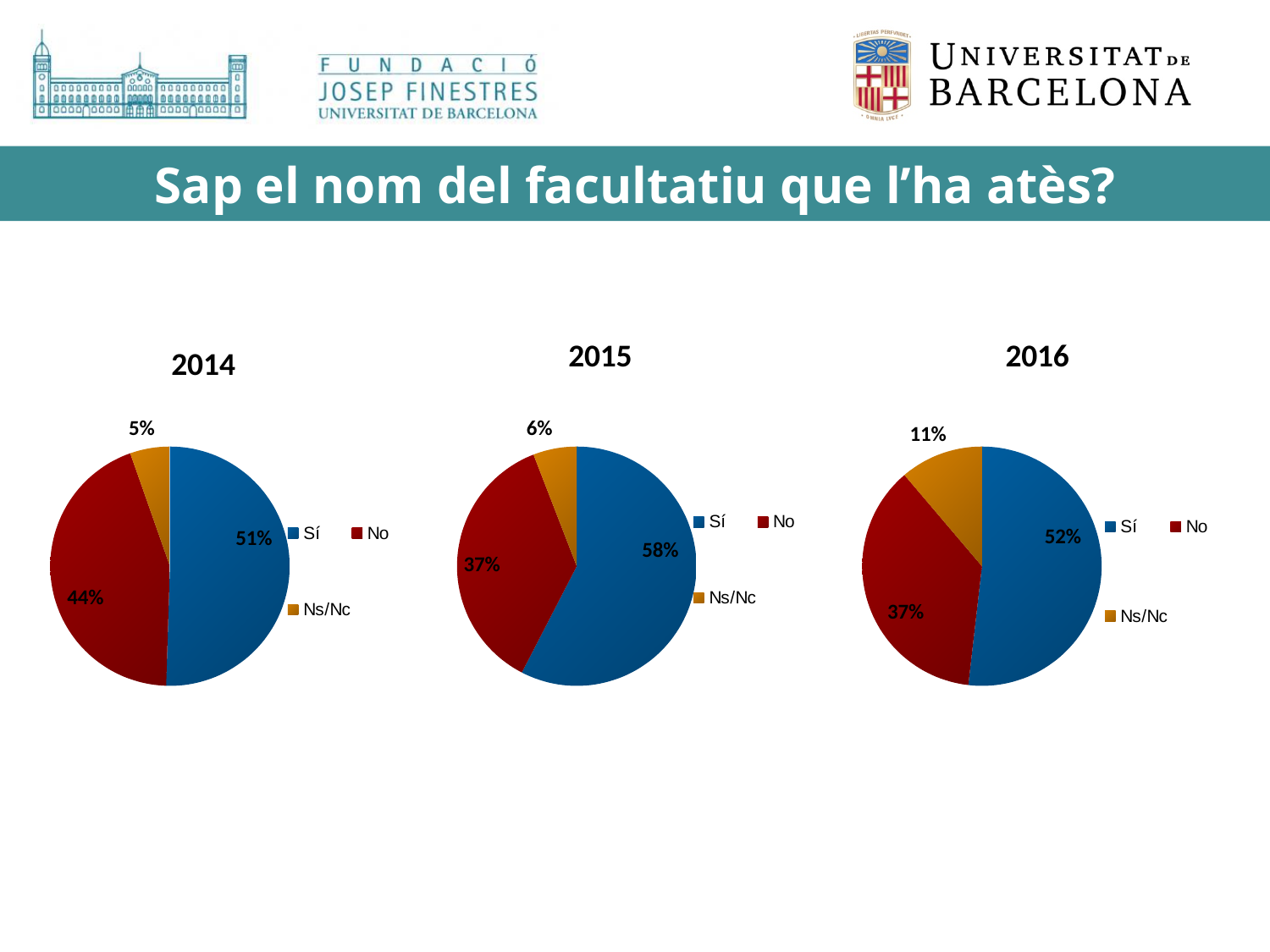
In the 2014 pie chart, what share of respondents answered Sí? 51% What kind of chart is used for the 2015 data? Pie chart In the 2016 pie chart, which category has the largest slice? Sí In the 2015 pie chart, what share of respondents answered Sí? 58% In the 2014 pie chart, what share of respondents answered No? 44% In the 2015 pie chart, which category has the smallest slice? Ns/Nc In the 2014 pie chart, what is the difference between the Sí and No shares? 7% In the 2016 pie chart, what share of respondents answered Ns/Nc? 11% In the 2016 pie chart, what colour is the No slice? Red How many slices does the 2016 pie chart have? 3 How many entries does the legend of the 2014 chart list? 3 In the 2015 pie chart, which is larger, the Sí slice or the No slice? Sí